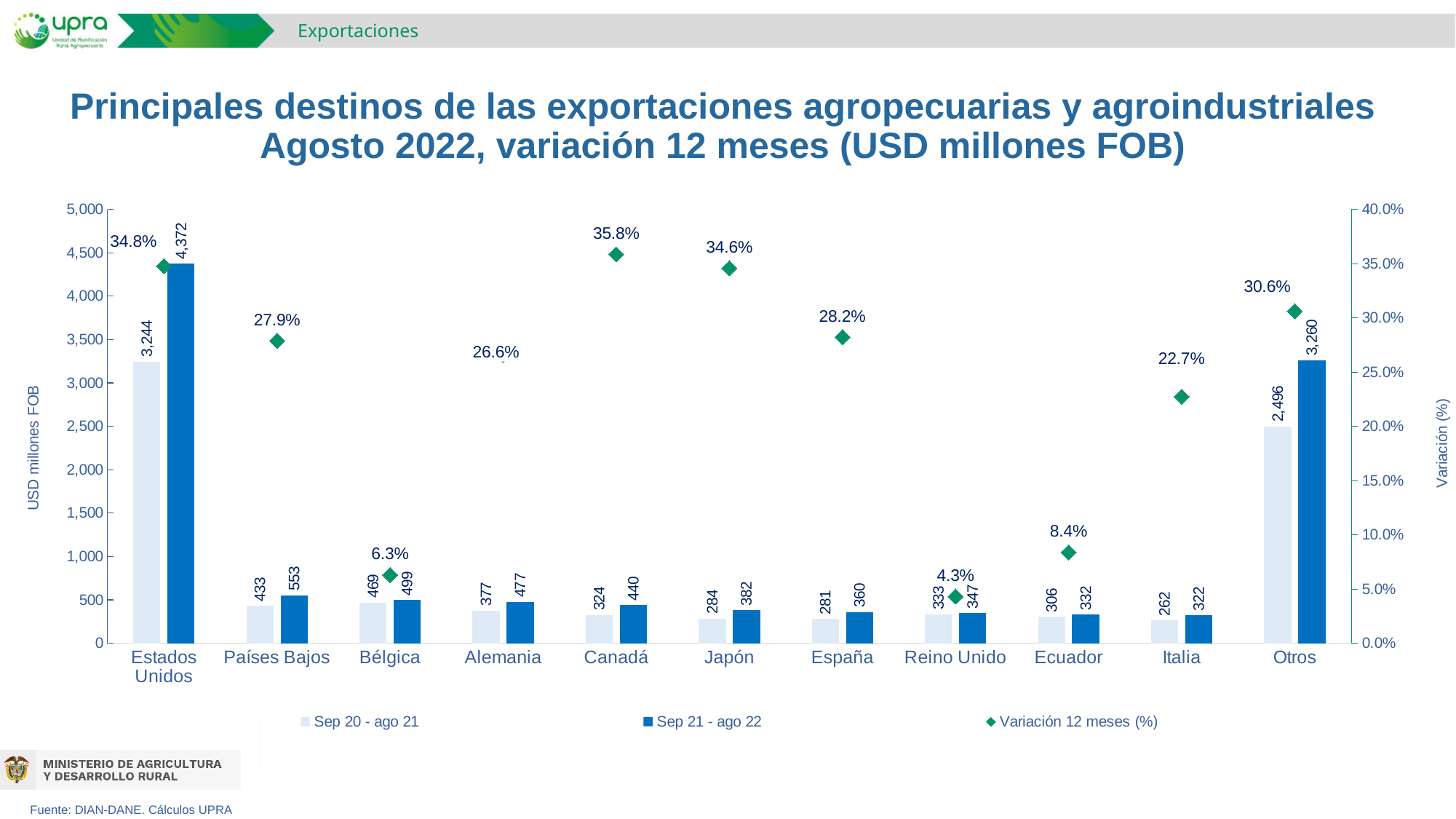
What is the label of the left vertical axis? USD millones FOB What is the value for Países Bajos in the Sep 20 - ago 21 series? 433 Which category has the highest value in the Sep 21 - ago 22 series? Estados Unidos Is the Sep 21 - ago 22 value for Japón greater or less than 500? less Which category has the lowest Variación 12 meses (%)? Reino Unido How many categories are shown on the x axis? 11 Which category has the lowest value in the Sep 20 - ago 21 series? Italia Which is larger: the Sep 21 - ago 22 value for Bélgica or for Alemania? Bélgica What is the difference between the Sep 21 - ago 22 and Sep 20 - ago 21 values for Otros? 764 What is the Variación 12 meses (%) for Canadá? 35.8% How many series does the legend list? 3 What is the value for Estados Unidos in the Sep 21 - ago 22 series? 4,372